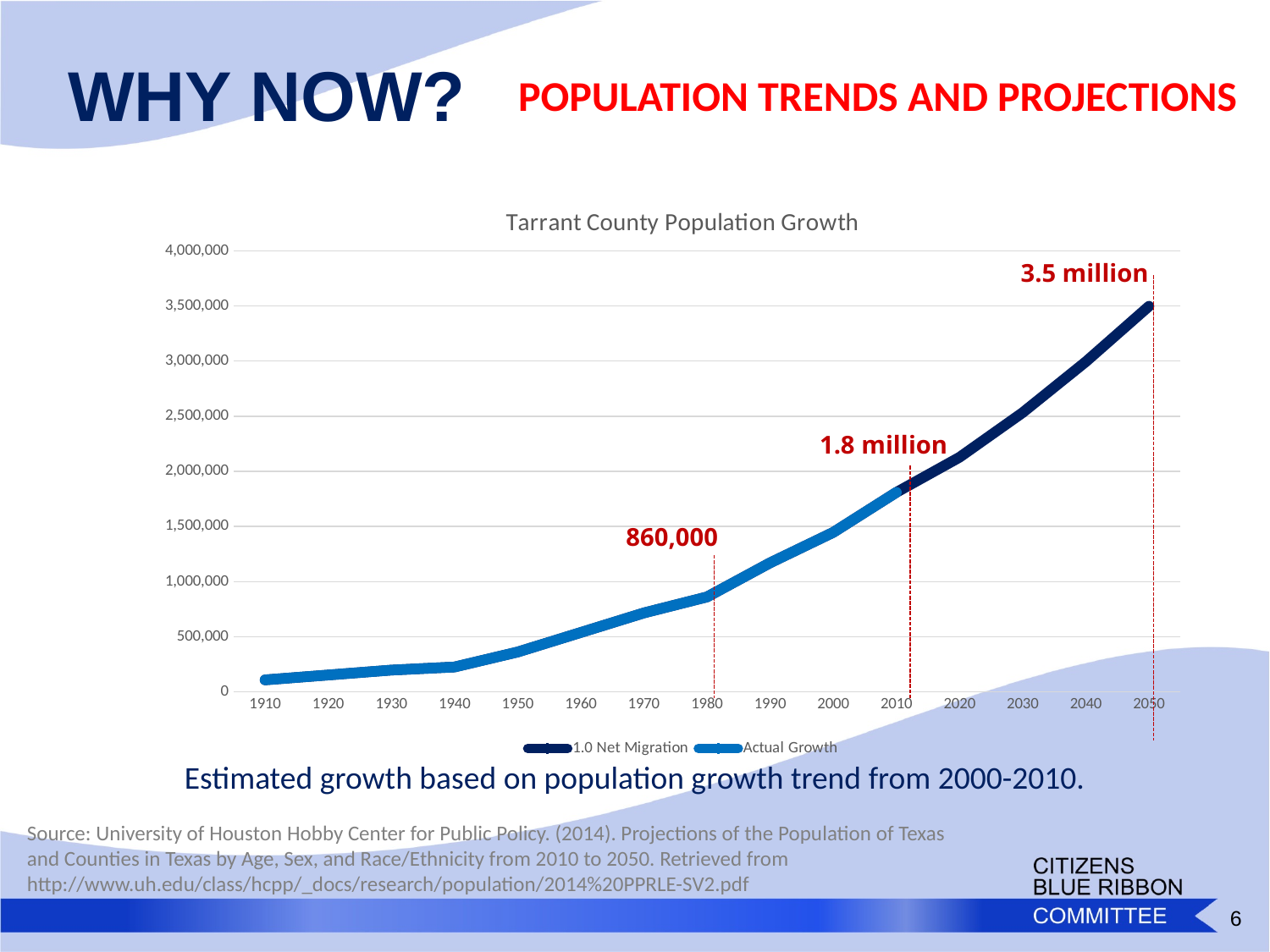
Which year has the lowest population value on the chart? 1910 Is the value for 1950 greater or less than 500,000? less How many years are marked along the x axis? 15 What type of chart is shown on the slide? Line chart What is the title of the chart? Tarrant County Population Growth What are the two series named in the legend? 1.0 Net Migration and Actual Growth What population value is labelled for 2010? 1.8 million Which year has the highest population value on the chart? 2050 What population value is labelled for 1980? 860,000 Do the population values rise or fall from 1910 to 2050? Rise How many series does the chart legend list? 2 What population value is labelled for 2050? 3.5 million